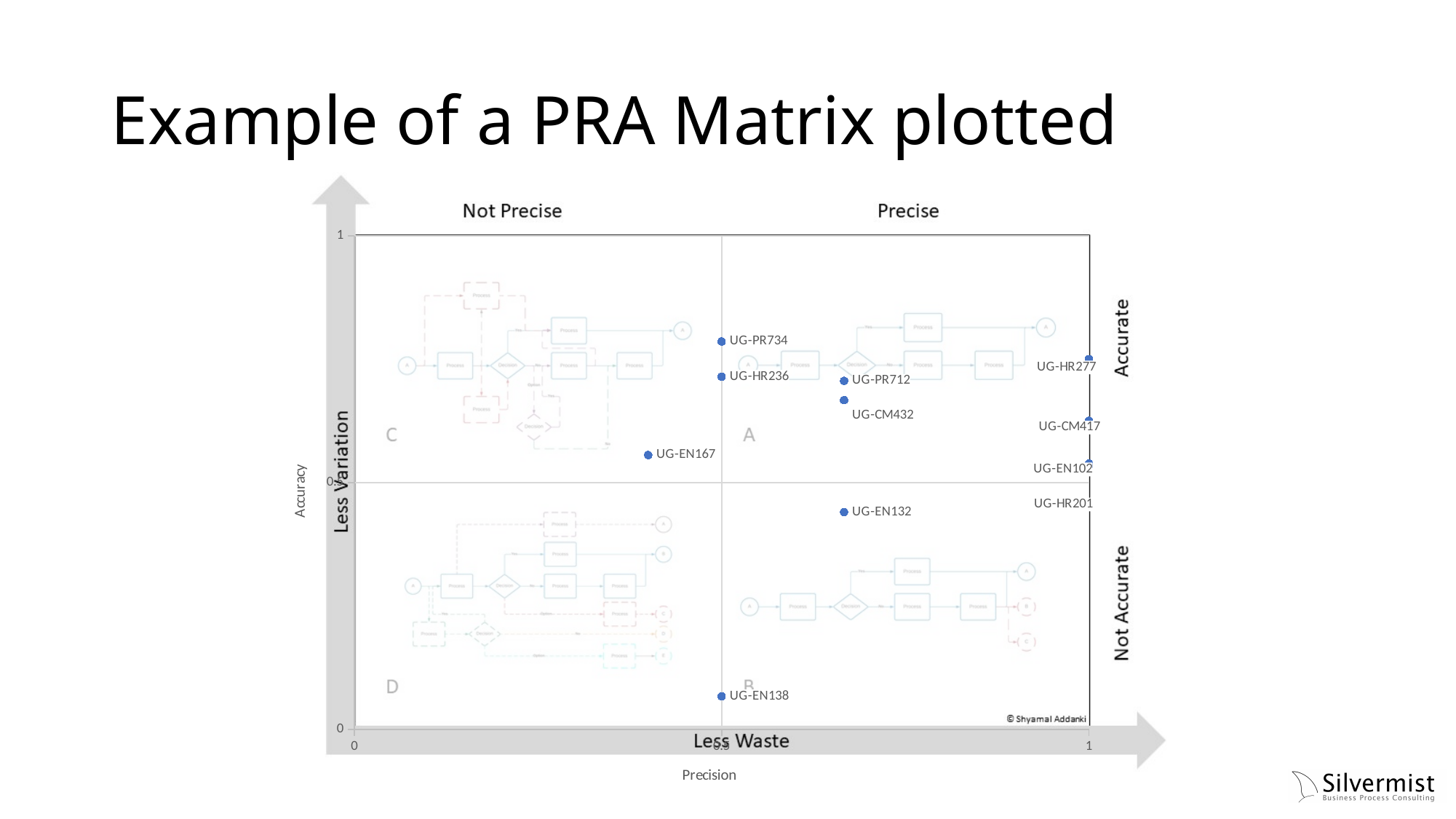
Which has the higher Accuracy value, UG-EN132 or UG-EN138? UG-EN132 Is the Accuracy value for UG-PR712 greater or less than 0.5? greater Which has the higher Precision value, UG-EN167 or UG-EN132? UG-EN132 Is the Accuracy value for UG-EN138 greater or less than 0.5? less Is the Precision value for UG-EN132 greater or less than 0.5? greater What is the title of the horizontal axis of the chart? Precision Which data point has the lowest Accuracy value? UG-EN138 How many labelled data points are plotted on the chart? 11 Which data point has the lowest Precision value? UG-EN167 What kind of chart is shown on the slide? scatter chart What is the title of the vertical axis of the chart? Accuracy